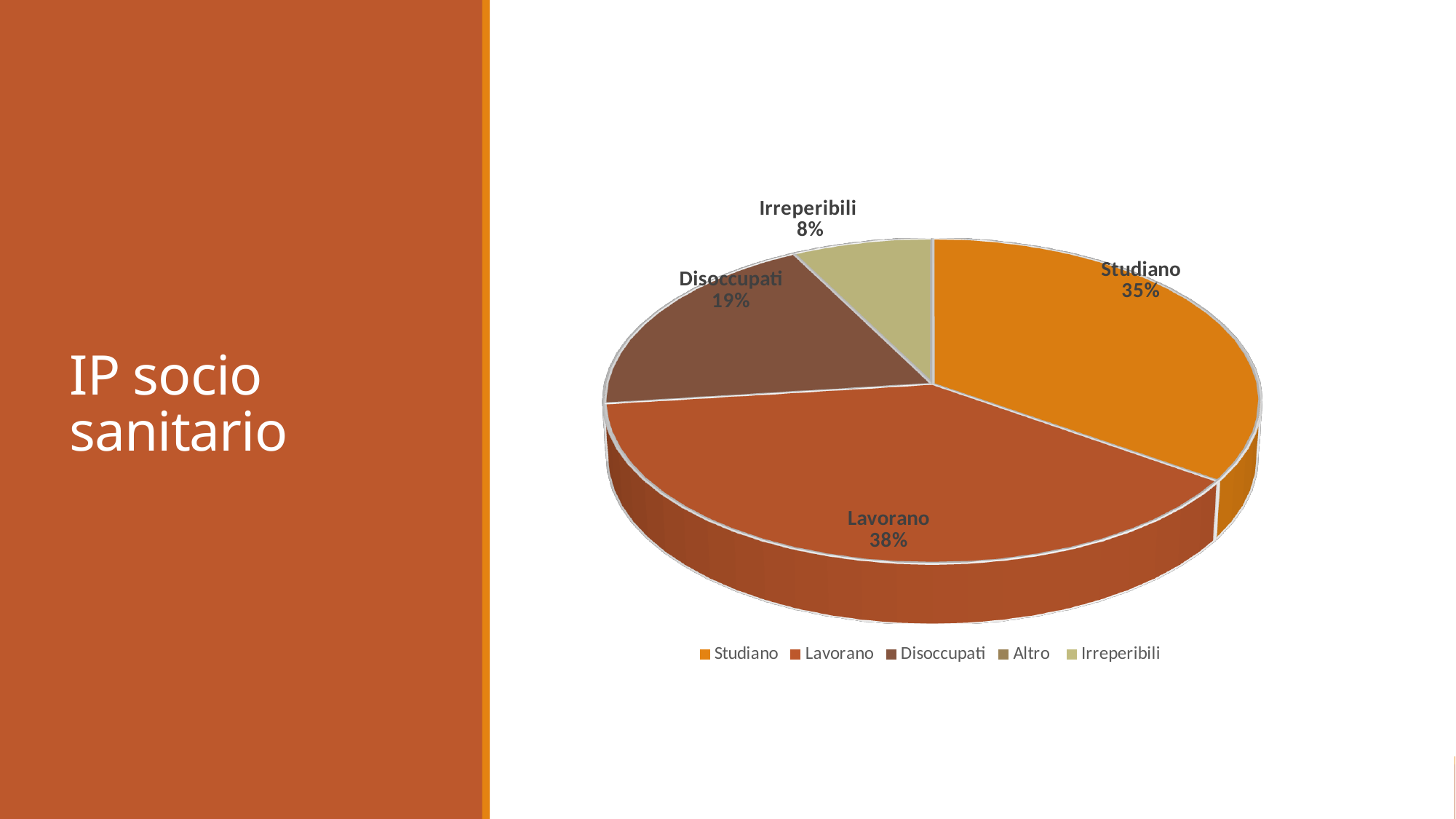
What percentage of the pie is labelled Studiano? 35% What is the difference in percentage points between Disoccupati and Irreperibili? 11 What type of chart is shown on the slide? pie chart What is the title text shown on the left of the slide? IP socio sanitario Which category has the largest share of the pie? Lavorano What is the difference in percentage points between Lavorano and Studiano? 3 Which is larger, the share for Disoccupati or the share for Irreperibili? Disoccupati Which labelled category has the smallest share of the pie? Irreperibili What percentage of the pie is labelled Irreperibili? 8% What percentage of the pie is labelled Disoccupati? 19% What percentage of the pie is labelled Lavorano? 38% How many entries does the legend list? 5